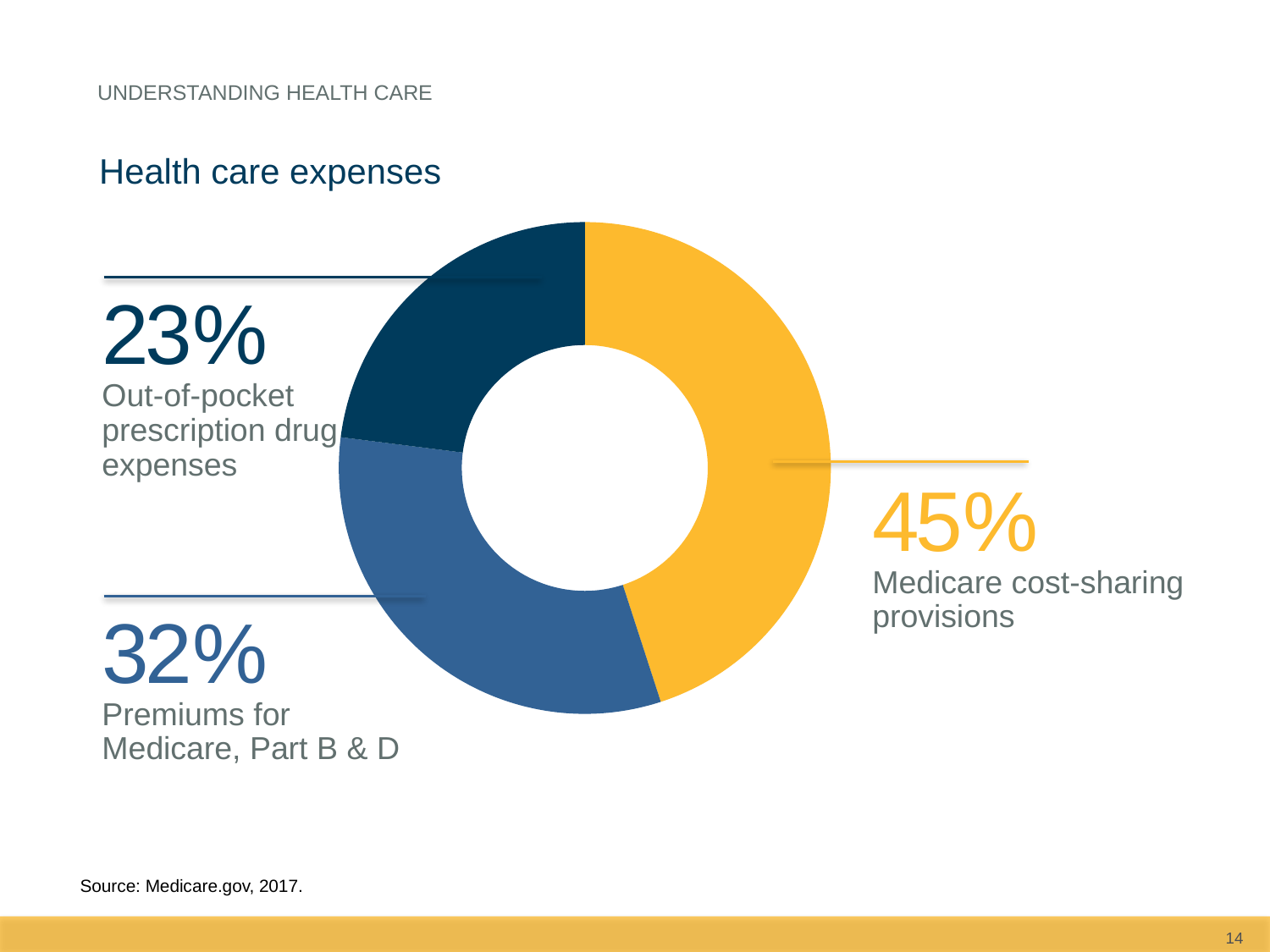
What colour is the segment representing Medicare cost-sharing provisions? Yellow How many percentage points larger is the Medicare cost-sharing provisions share than the premiums for Medicare, Part B & D share? 13 percentage points Which is larger: the share for premiums for Medicare, Part B & D or the share for out-of-pocket prescription drug expenses? Premiums for Medicare, Part B & D What kind of chart is shown on the slide? Donut (pie) chart What is the title of the chart? Health care expenses What percentage of health care expenses goes to premiums for Medicare, Part B & D? 32% Which category accounts for the smallest share of health care expenses? Out-of-pocket prescription drug expenses What percentage of health care expenses is out-of-pocket prescription drug expenses? 23% How many categories are shown in the chart? 3 What is the difference between the premiums for Medicare, Part B & D share and the out-of-pocket prescription drug expenses share? 9 percentage points Which category accounts for the largest share of health care expenses? Medicare cost-sharing provisions What share of health care expenses is attributed to Medicare cost-sharing provisions? 45%